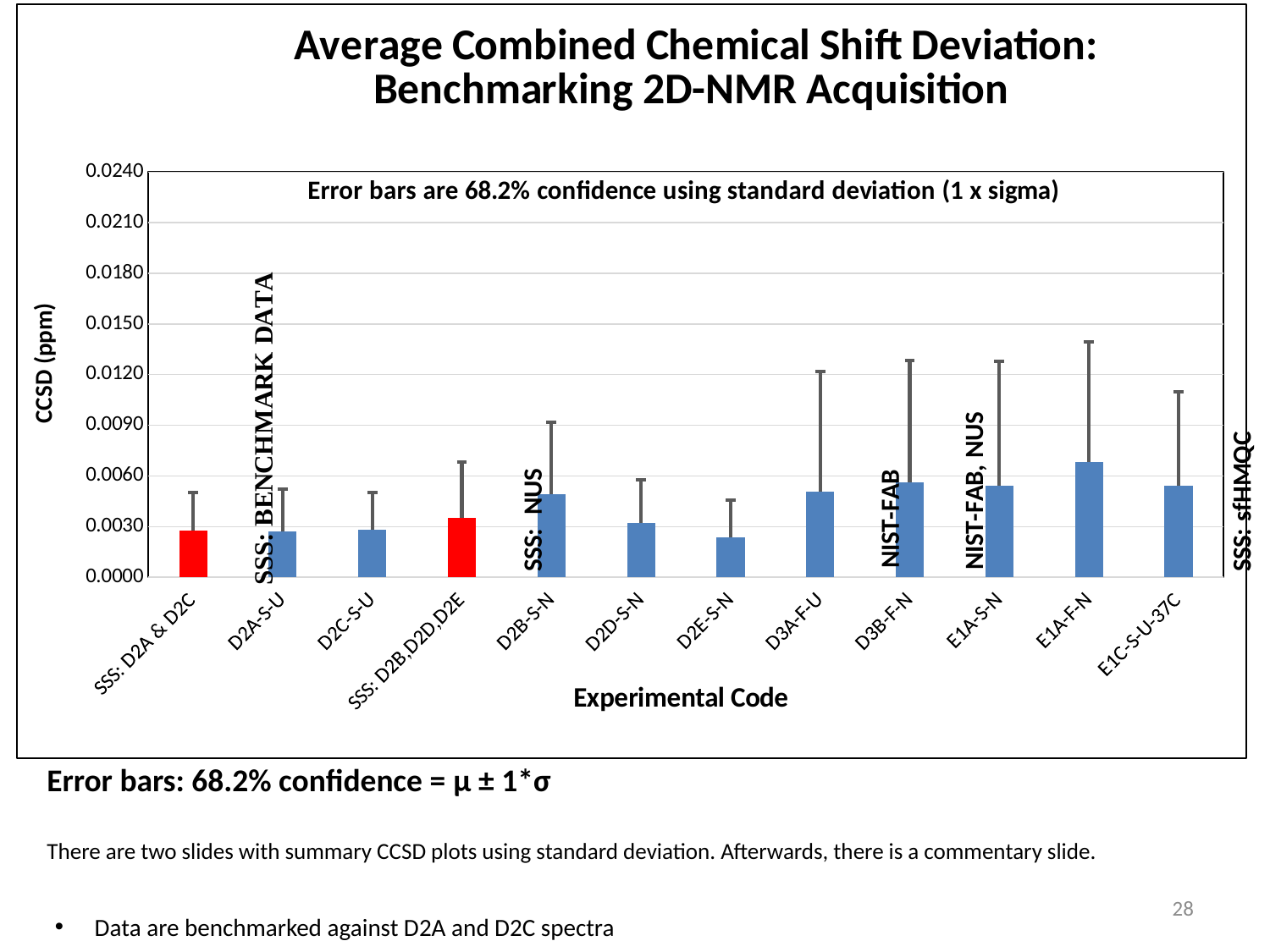
Is the value for D2E-S-N greater or less than 0.0030? less Which experimental code has the lowest average CCSD bar? D2E-S-N How many experimental codes (categories) are plotted on the x axis? 12 What is the label of the y axis? CCSD (ppm) What kind of chart is shown on the slide? bar chart Is the value for D2B-S-N greater or less than 0.0060? less Which has the larger bar, D3B-F-N or D2A-S-U? D3B-F-N Is the value for SSS: D2B,D2D,D2E greater or less than 0.0030? greater How many bars are coloured red? 2 Which has the larger bar, E1A-F-N or D2D-S-N? E1A-F-N Which experimental code has the highest average CCSD bar? E1A-F-N